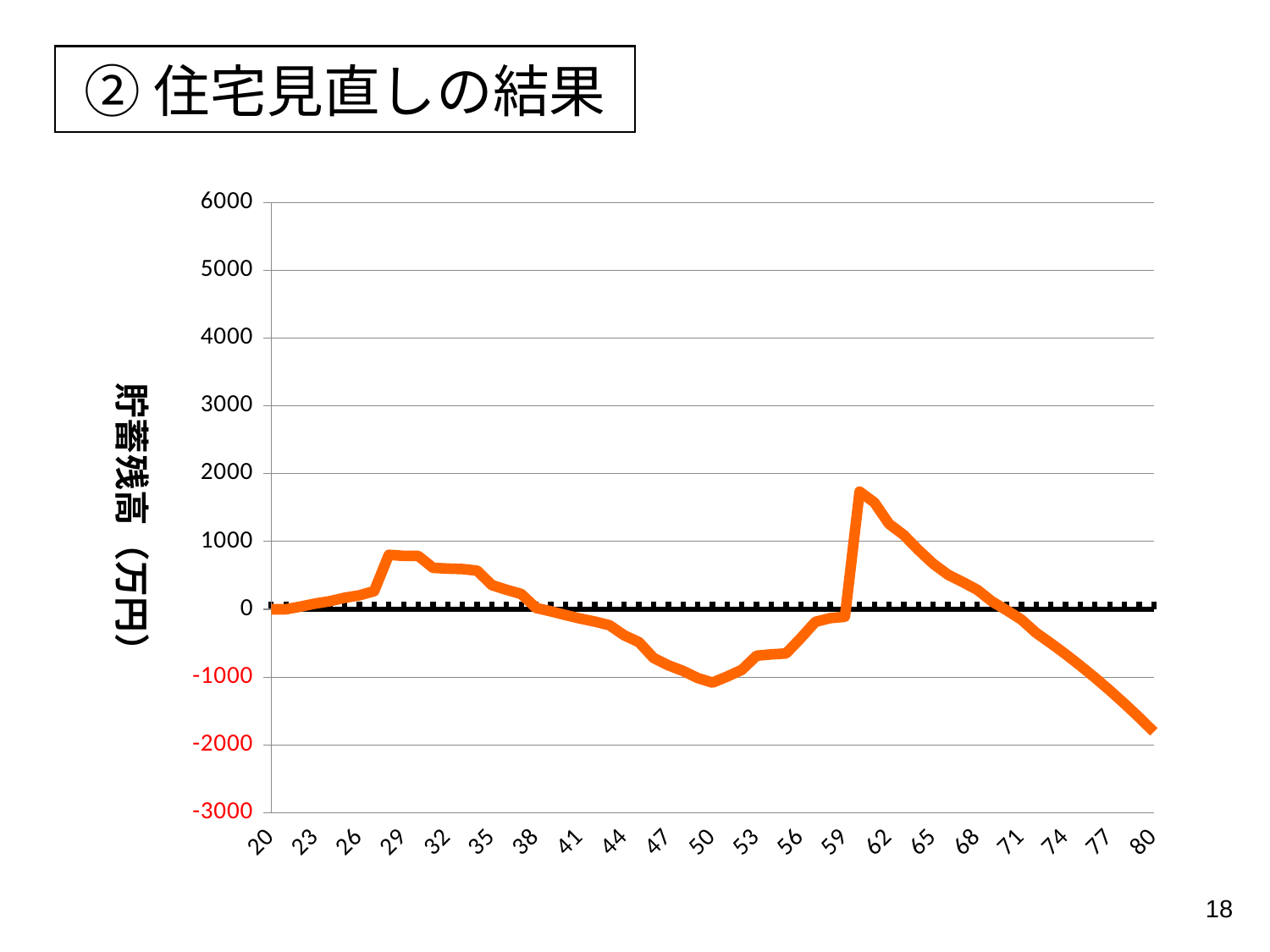
What is the highest value shown on the vertical axis? 6000 Is the value at age 62 greater or less than 1000? greater Which is larger, the value at age 29 or the value at age 62? age 62 Is the value at age 44 greater or less than 0? less Is the value at age 80 greater or less than -1000? less Do the values rise or fall from age 62 to age 80? fall How many age labels are shown on the horizontal axis? 21 What kind of chart is shown on the slide? line chart At which labeled age is the value lowest? 80 What is the label of the vertical axis? 貯蓄残高（万円）